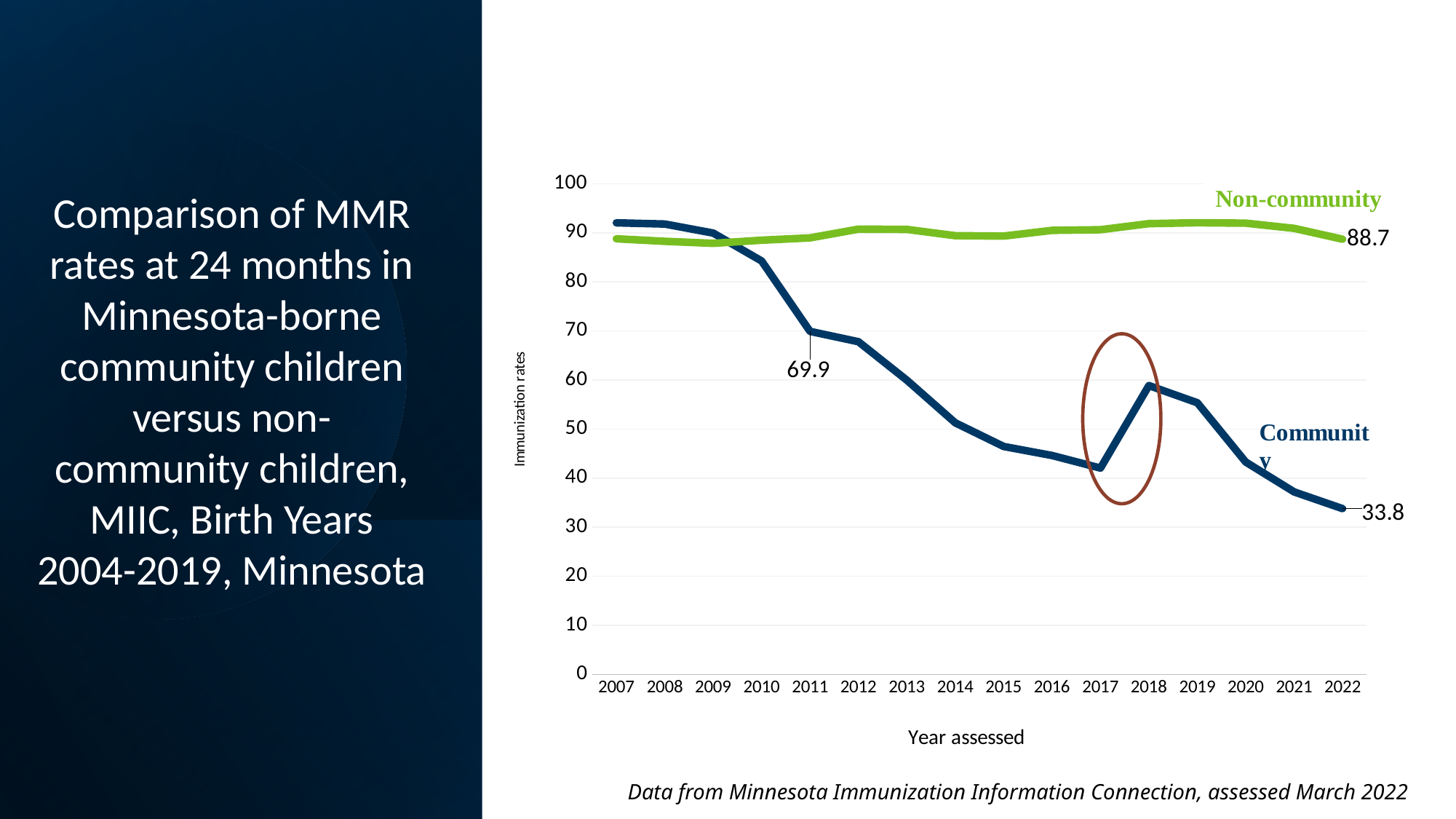
In 2022, how much higher is the Non-community rate than the Community rate? 54.9 How many years are shown on the x axis? 16 What is the Non-community immunization rate for 2022? 88.7 How many series are plotted on the chart? 2 What is the Community immunization rate for 2011? 69.9 By how much did the Community rate fall between 2011 and 2022? 36.1 In 2022, which series has the higher immunization rate, Community or Non-community? Non-community Is the Community value for 2010 greater or less than 80? greater Is the Community value for 2017 greater or less than 50? less What is the Community immunization rate for 2022? 33.8 Does the Community series overall rise or fall from 2007 to 2022? fall What type of chart is shown on the slide? line chart